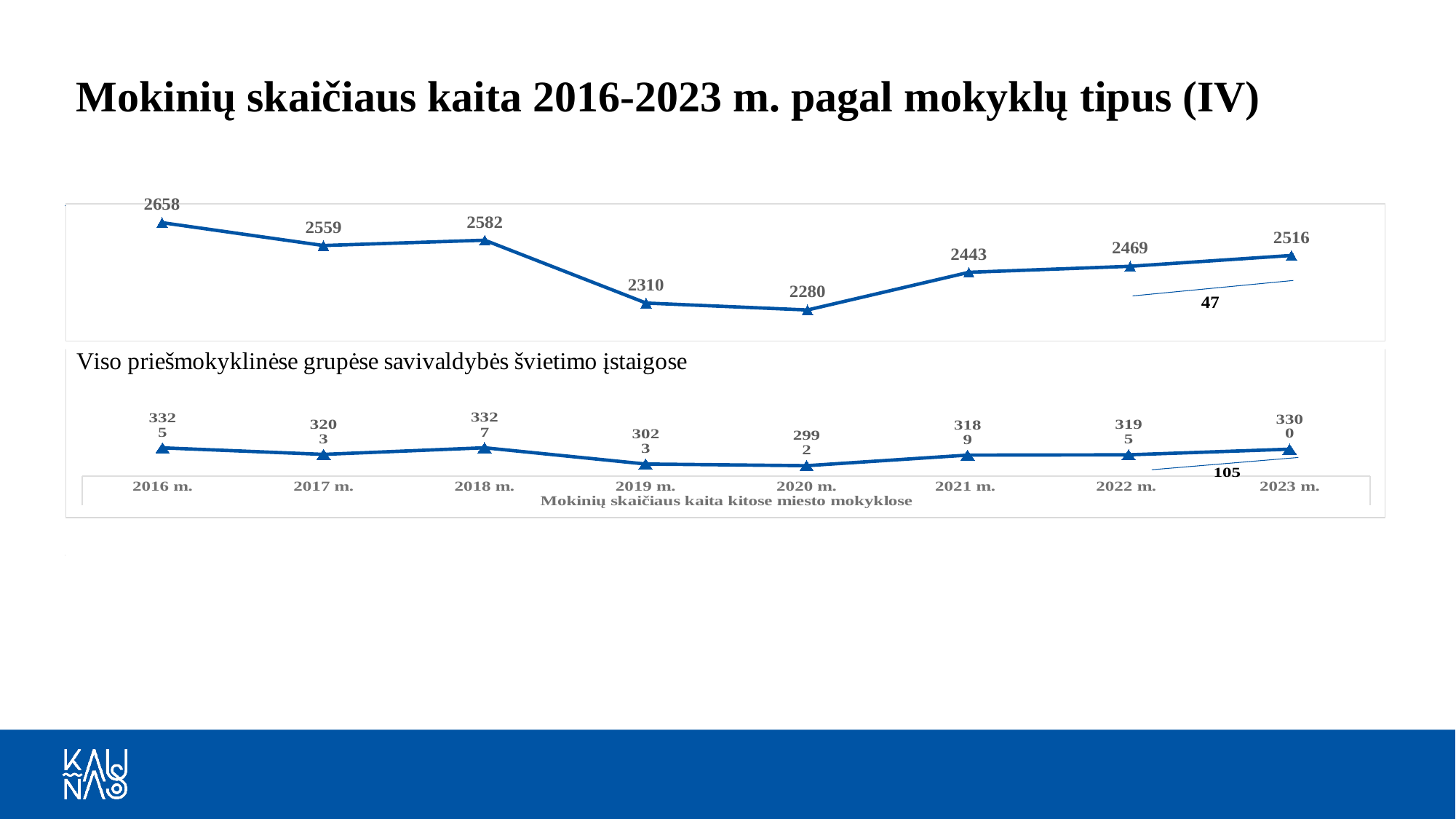
In the top chart, which year has the highest value? 2016 m. In the top chart, what is the value for 2020 m.? 2280 In the bottom chart, what is the value for 2023 m.? 3300 In the top chart, which year has the lowest value? 2020 m. In the bottom chart, what is the difference between the values for 2023 m. and 2022 m.? 105 In the top chart, is the value for 2018 m. larger than the value for 2017 m.? Yes, 2582 vs 2559 In the top chart, what is the value for 2016 m.? 2658 How many data points are plotted in the top chart? 8 In the top chart, what is the difference between the values for 2023 m. and 2022 m.? 47 What type of chart is the top chart? Line chart What is the title shown at the bottom of the lower chart? Mokinių skaičiaus kaita kitose miesto mokyklose In the bottom chart, which year has the lowest value? 2020 m.